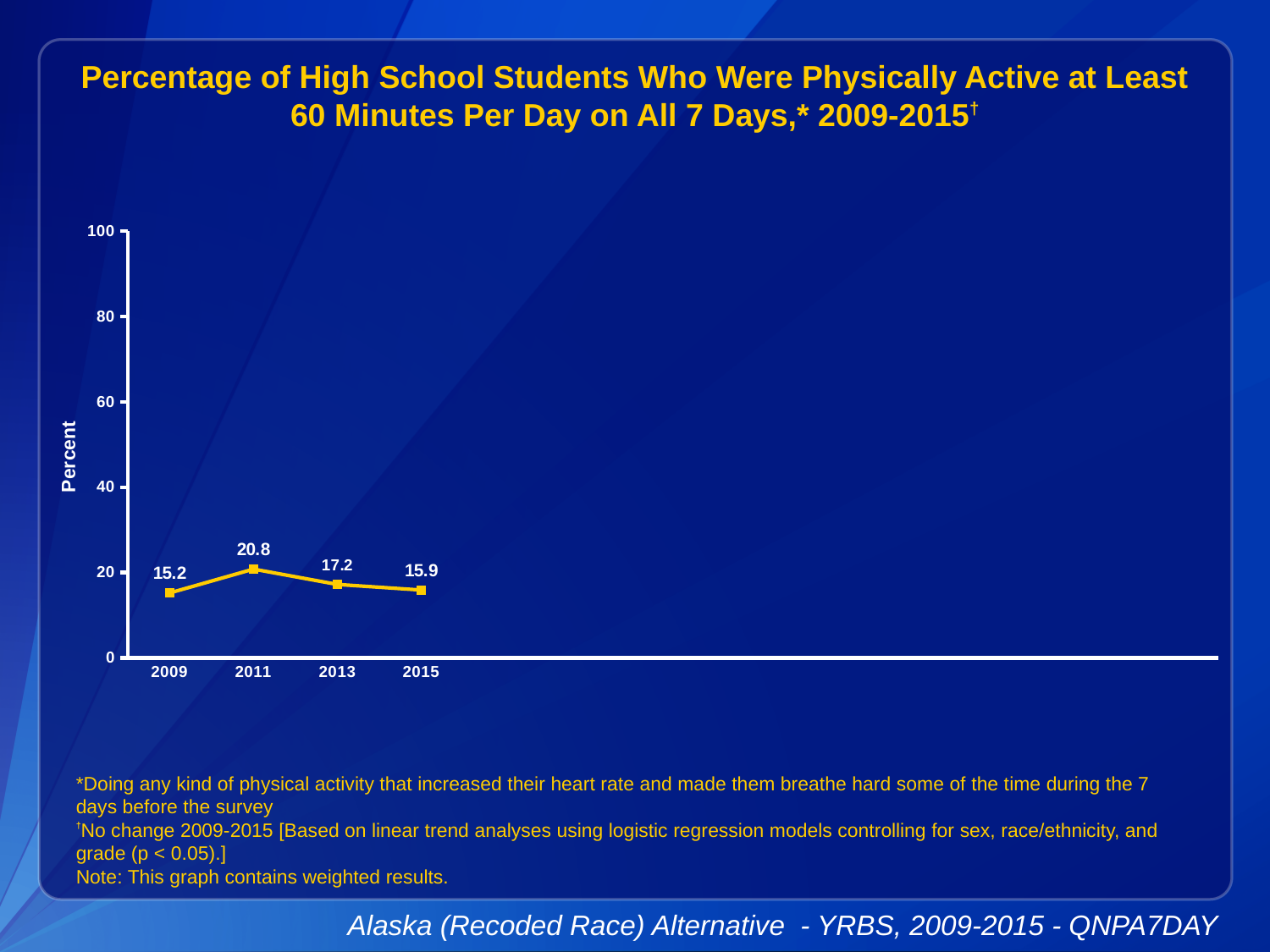
What is the value for 2011? 20.8 What kind of chart is shown on the slide? line chart Which is larger, the value for 2013 or the value for 2015? 2013 What is the label on the y axis? Percent Which year has the lowest value? 2009 What is the value for 2015? 15.9 What is the difference between the values for 2011 and 2015? 4.9 What is the value for 2009? 15.2 How many years are plotted on the chart? 4 Is the value for 2011 greater or less than 20? greater What is the value for 2013? 17.2 Which year has the highest value? 2011